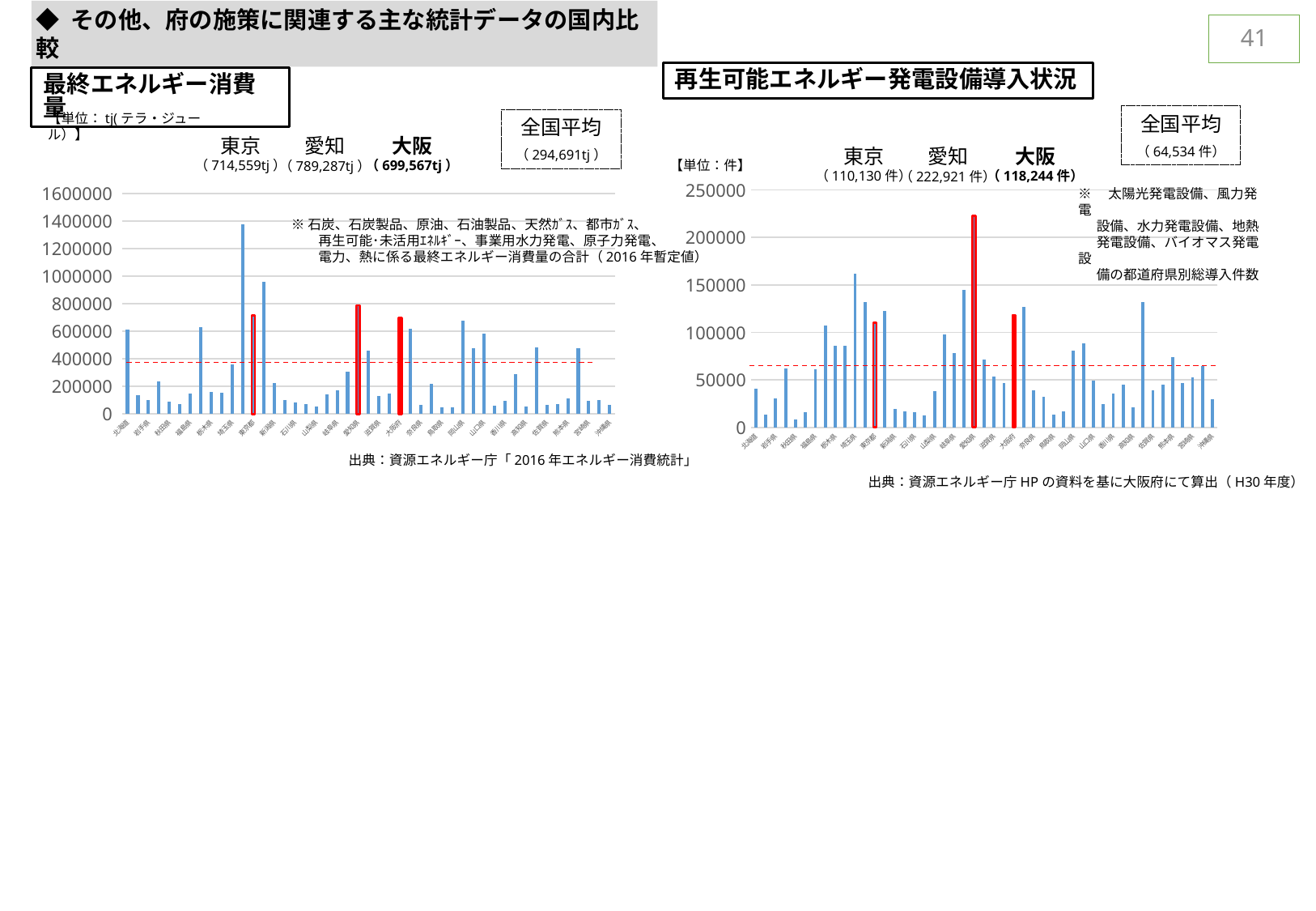
In the 最終エネルギー消費量 chart on the left, what is the 全国平均 (national average) shown? 294,691tj In the 再生可能エネルギー発電設備導入状況 chart on the right, what is the value printed for 大阪? 118,244件 In the 最終エネルギー消費量 chart on the left, which is larger, the value for 大阪 or the 全国平均? 大阪 What kind of chart is the 再生可能エネルギー発電設備導入状況 chart on the right? bar chart In the 再生可能エネルギー発電設備導入状況 chart on the right, what is the 全国平均 (national average) shown? 64,534件 In the 再生可能エネルギー発電設備導入状況 chart on the right, which is larger, the value for 東京 or for 大阪? 大阪 In the 最終エネルギー消費量 chart on the left, what is the value printed for 愛知? 789,287tj In the 最終エネルギー消費量 chart on the left, what is the value printed for 大阪? 699,567tj In the 再生可能エネルギー発電設備導入状況 chart on the right, what is the difference between the printed values for 大阪 and 東京? 8,114件 In the 最終エネルギー消費量 chart on the left, which of 東京, 愛知 and 大阪 has the highest printed value? 愛知 In the 最終エネルギー消費量 chart on the left, what is the difference between the printed values for 愛知 and 大阪? 89,720tj In the 再生可能エネルギー発電設備導入状況 chart on the right, what is the value printed for 愛知? 222,921件